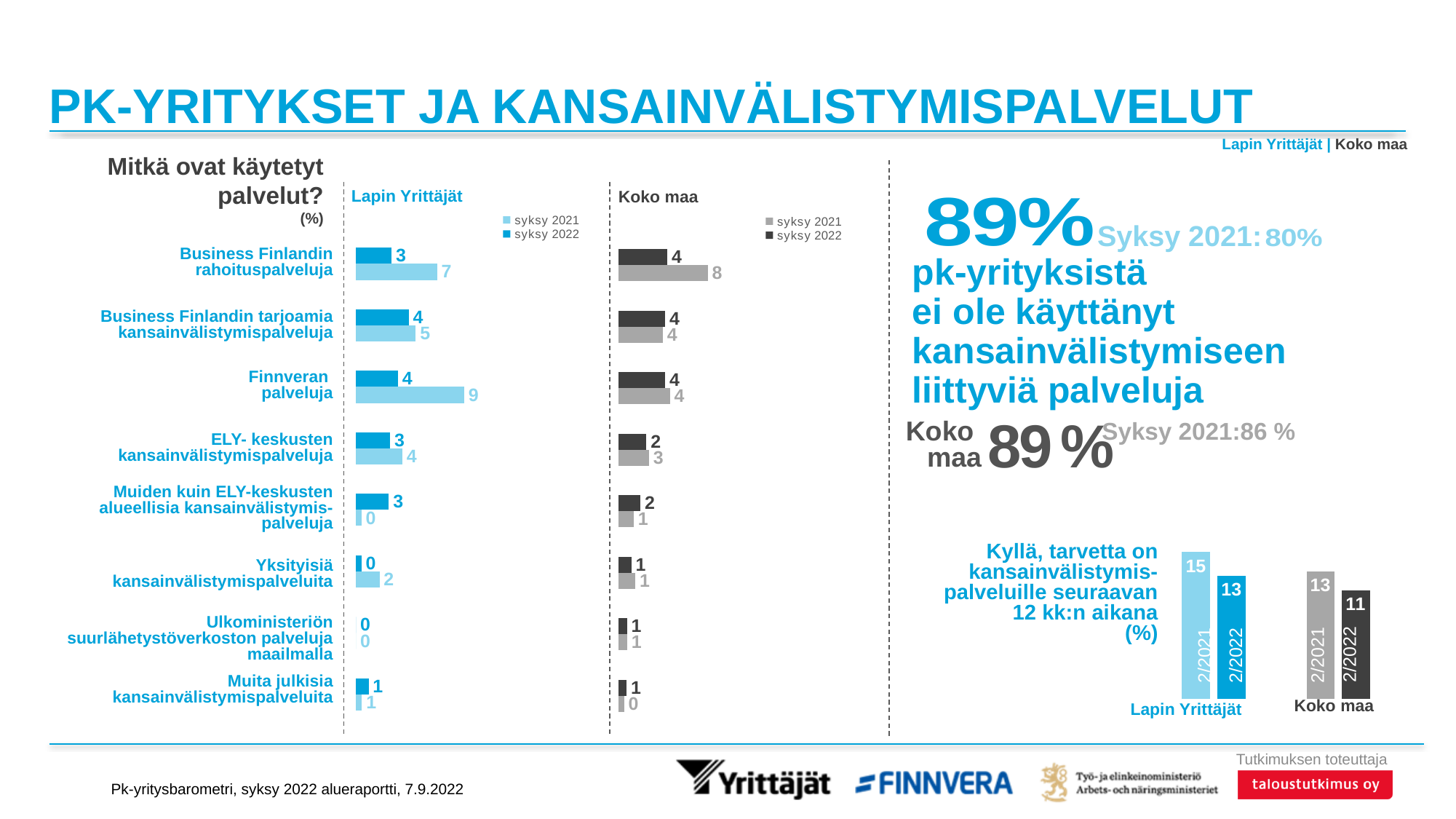
How many series does the legend of the Koko maa chart list? 2 In the Lapin Yrittäjät chart, what is the difference between the syksy 2021 and syksy 2022 values for Finnveran palveluja? 5 In the chart on the right about need for internationalisation services in the next 12 months, what is the 2/2022 value for Koko maa? 11 In the Lapin Yrittäjät chart, which is larger for Yksityisiä kansainvälistymispalveluita: the syksy 2021 value or the syksy 2022 value? syksy 2021 In the Koko maa chart, what is the difference between the syksy 2021 and syksy 2022 values for Business Finlandin rahoituspalveluja? 4 In the Koko maa chart, which category has the highest syksy 2021 value? Business Finlandin rahoituspalveluja In the Koko maa chart, what is the syksy 2022 value for ELY- keskusten kansainvälistymispalveluja? 2 In the Lapin Yrittäjät chart, what is the syksy 2021 value for Finnveran palveluja? 9 How many categories are shown in the Lapin Yrittäjät chart? 8 In the Lapin Yrittäjät chart, what is the syksy 2022 value for Business Finlandin rahoituspalveluja? 3 In the Koko maa chart, what is the syksy 2021 value for Business Finlandin rahoituspalveluja? 8 In the Lapin Yrittäjät chart, which category has the highest syksy 2021 value? Finnveran palveluja